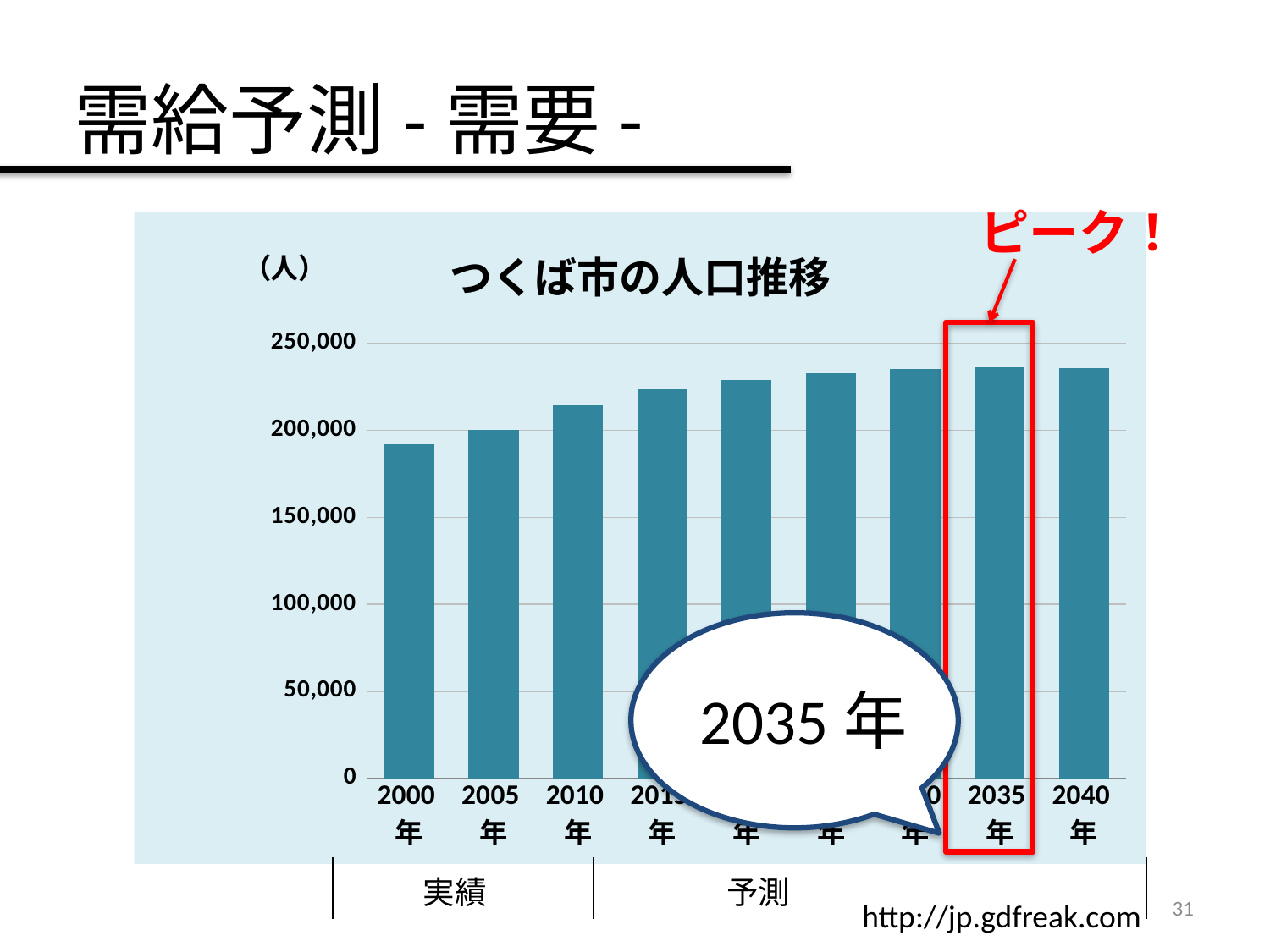
Which year has the lowest population in the chart? 2000年 What is the title of the chart? つくば市の人口推移 Is the value for 2035年 greater or less than 250,000? less Which is larger, the value for 2000年 or the value for 2010年? 2010年 How many bars (years) are plotted in the chart? 9 According to the slide's annotation, in which year does the population peak? 2035年 Is the value for 2010年 greater or less than 200,000? greater What kind of chart is shown on the slide? bar chart Is the value for 2000年 greater or less than 200,000? less Do the values generally rise or fall from 2000年 to 2035年? rise What unit is shown for the vertical axis of the chart? 人